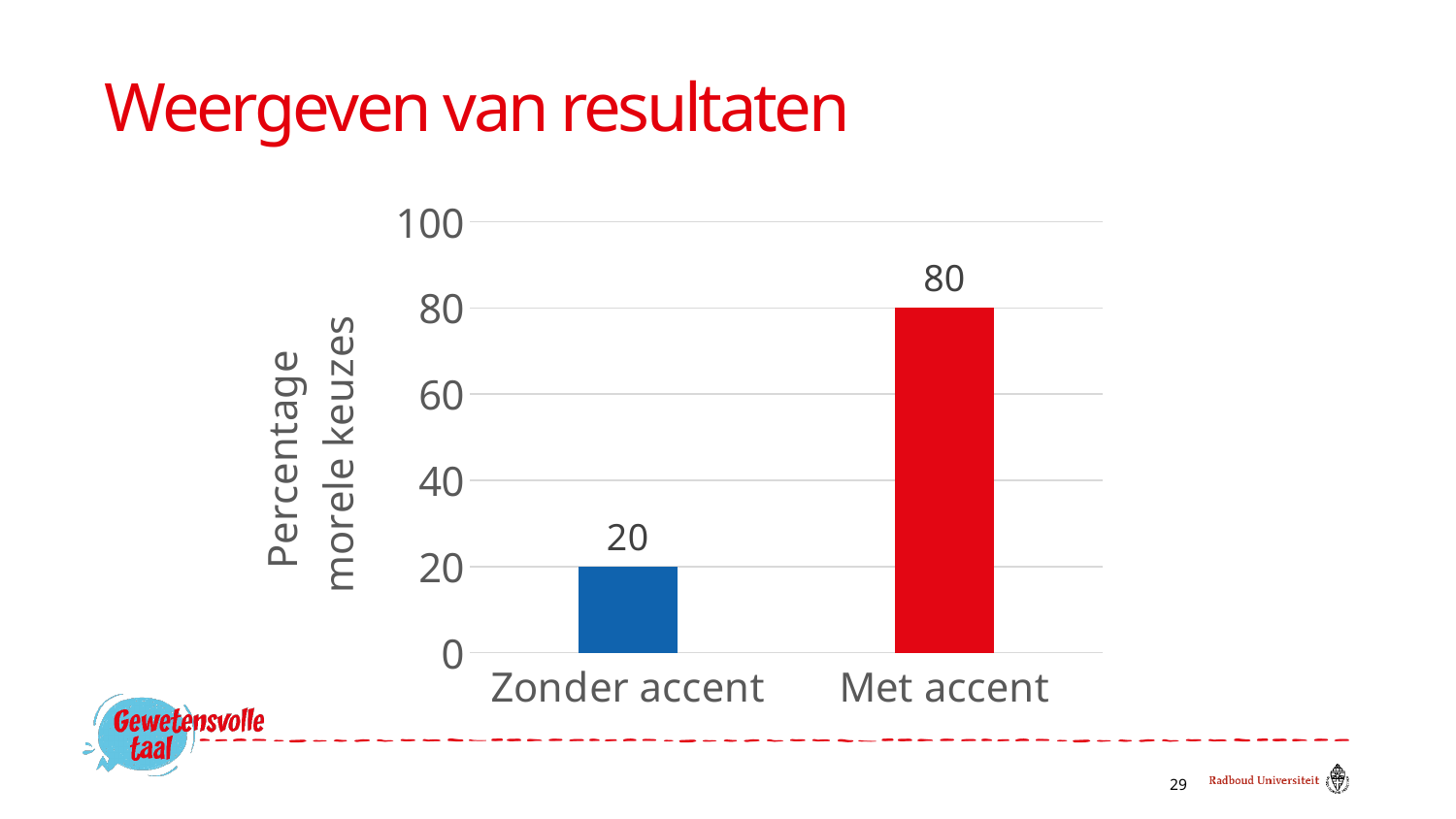
Is the value for Met accent greater or less than 60? greater What is the value for Met accent? 80 Which category has the lowest value? Zonder accent What colour is the bar for Met accent? red What is the value for Zonder accent? 20 What kind of chart is shown on the slide? bar chart What is the difference between the values for Met accent and Zonder accent? 60 Which category has the highest value? Met accent Which is larger, the value for Zonder accent or the value for Met accent? Met accent Is the value for Zonder accent greater or less than 40? less What is the label of the y axis? Percentage morele keuzes How many categories are shown on the x axis? 2